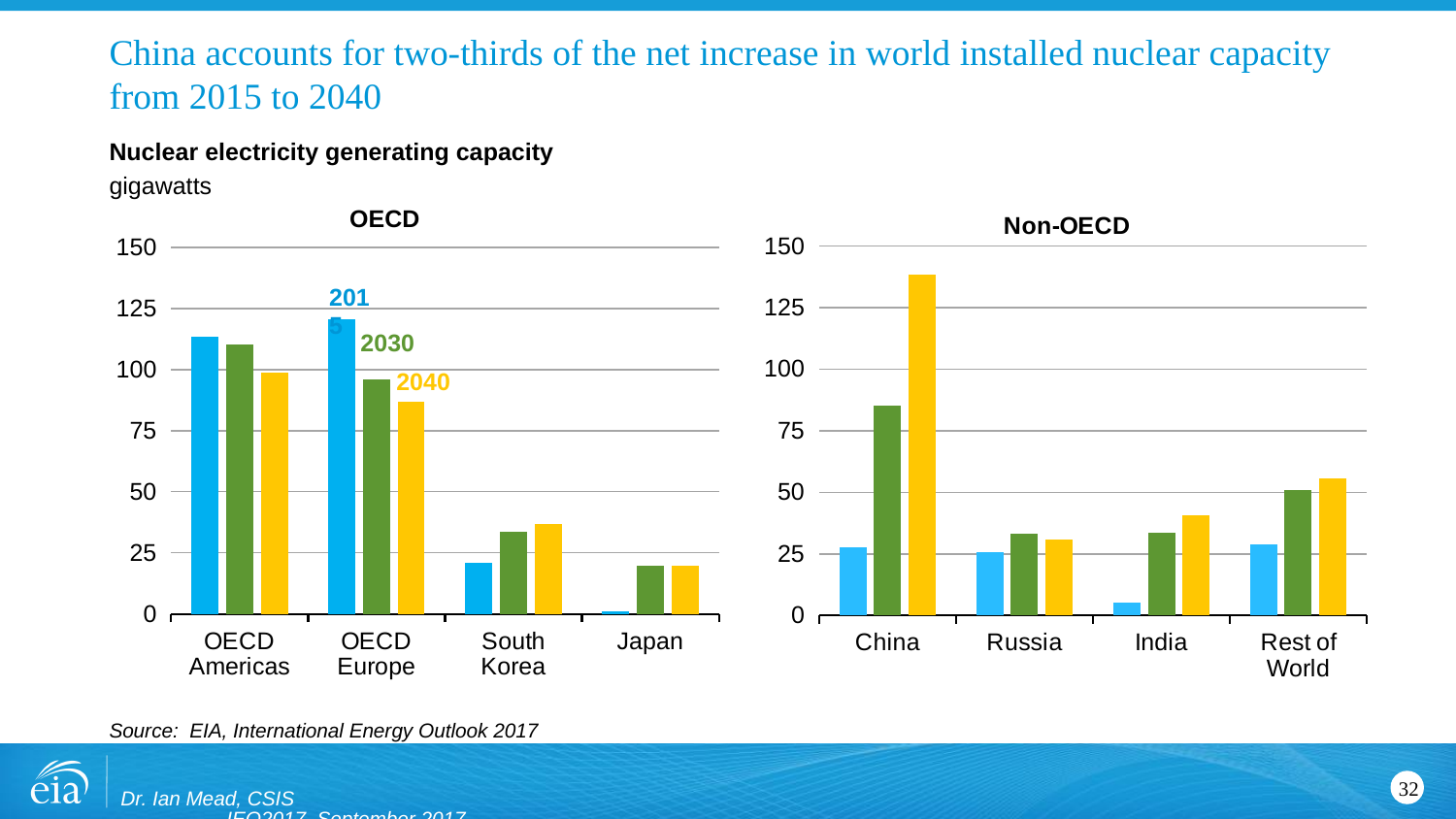
In the Non-OECD chart, how many regions or countries are shown on the x axis? 4 In the Non-OECD chart, which country has the highest 2040 value? China How many data series (years) are plotted in each chart? 3 In the OECD chart, is the 2015 value for OECD Europe greater or less than 100? greater In the Non-OECD chart, is the 2040 value for China greater or less than 125? greater In the Non-OECD chart, which country has the lowest 2015 value? India What kind of chart is used on this slide for the OECD and Non-OECD panels? Bar chart In the Non-OECD chart, do the bars for China rise or fall from 2015 to 2040? rise In the OECD chart, which region has the highest 2040 value? OECD Americas In the OECD chart, which is larger: the 2040 value for South Korea or the 2040 value for Japan? South Korea In the OECD chart, how many regions or countries are shown on the x axis? 4 In the OECD chart, which country has the lowest 2015 value? Japan